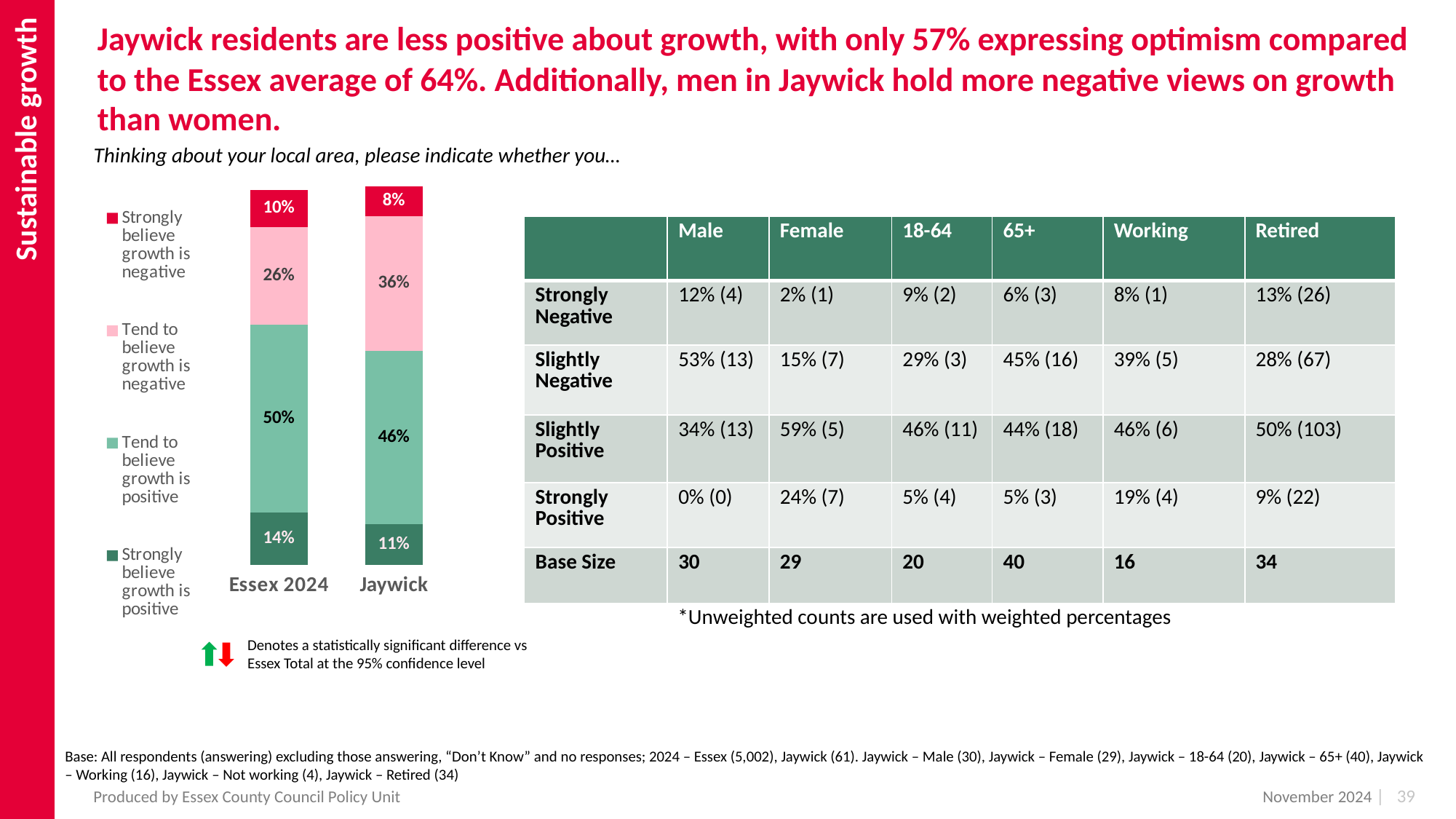
What percentage of Essex 2024 respondents strongly believe growth is negative? 10% What colour represents 'Strongly believe growth is negative' in the chart? Red Which bar has the larger share for 'Tend to believe growth is negative', Essex 2024 or Jaywick? Jaywick Which segment is the largest in the Jaywick bar? Tend to believe growth is positive How many bars (categories) does the chart show? 2 What percentage of Jaywick respondents tend to believe growth is negative? 36% What percentage of Essex 2024 respondents tend to believe growth is positive? 50% How many series does the chart legend list? 4 What type of chart is shown on the slide? Stacked bar chart What is the difference between the 'Tend to believe growth is positive' shares for Essex 2024 and Jaywick? 4 percentage points What percentage of Jaywick respondents strongly believe growth is positive? 11% Which segment is the smallest in the Essex 2024 bar? Strongly believe growth is negative